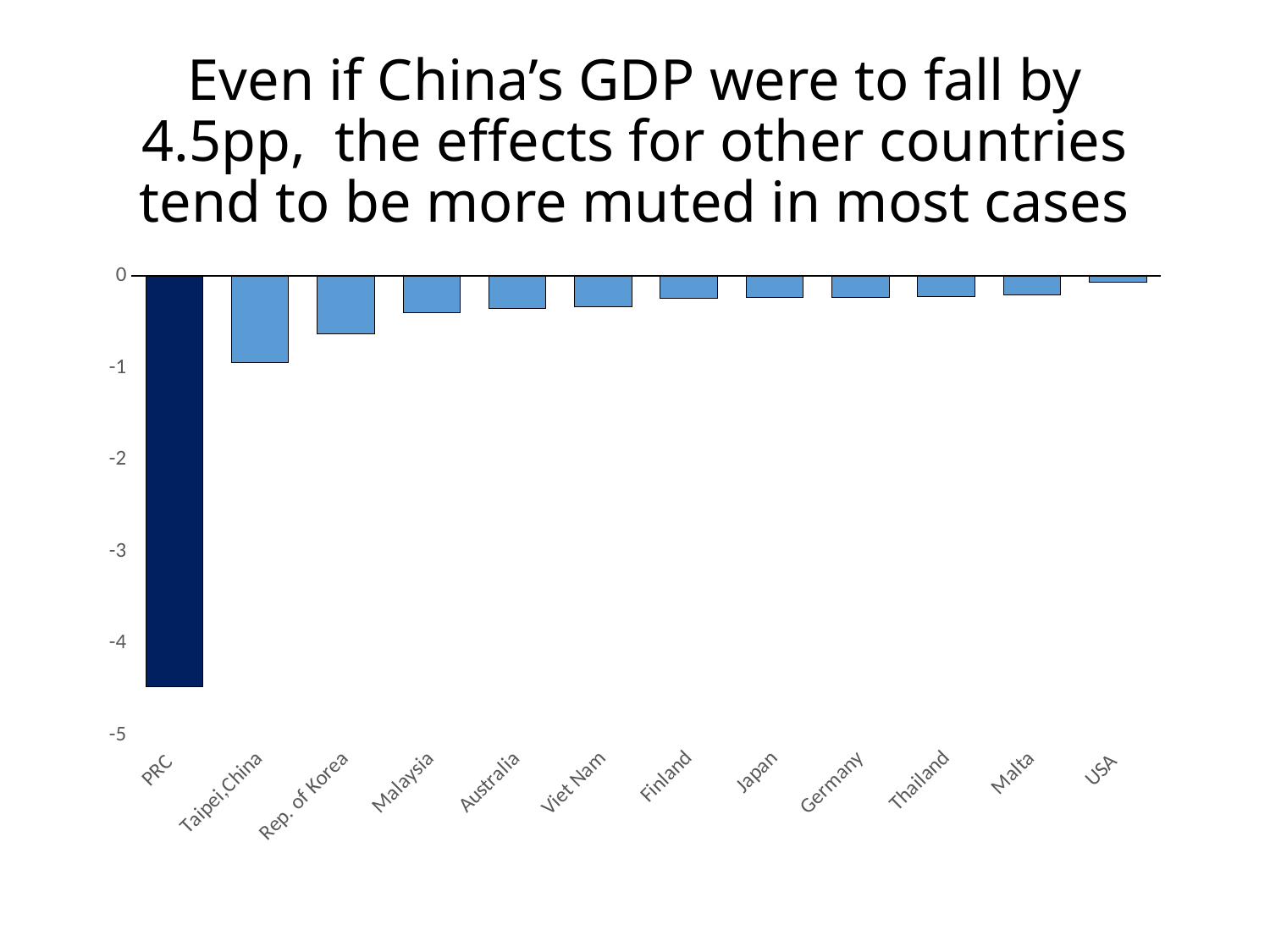
Which shows a larger decline, Rep. of Korea or Japan? Rep. of Korea What is the lowest value shown on the vertical axis of the chart? -5 Which shows a larger decline, PRC or Taipei,China? PRC Which country/economy has the highest (least negative) value in the chart? USA Is the value for Rep. of Korea greater or less than -1? greater What kind of chart is shown on the slide? bar chart How many countries/economies are shown on the x axis of the chart? 12 Which country/economy has the lowest (most negative) value in the chart? PRC Is the value for Malaysia greater or less than -1? greater Which bar in the chart is coloured dark navy rather than light blue? PRC Is the value for PRC greater or less than -4? less Do the bar values rise or fall moving from left to right along the x axis? rise